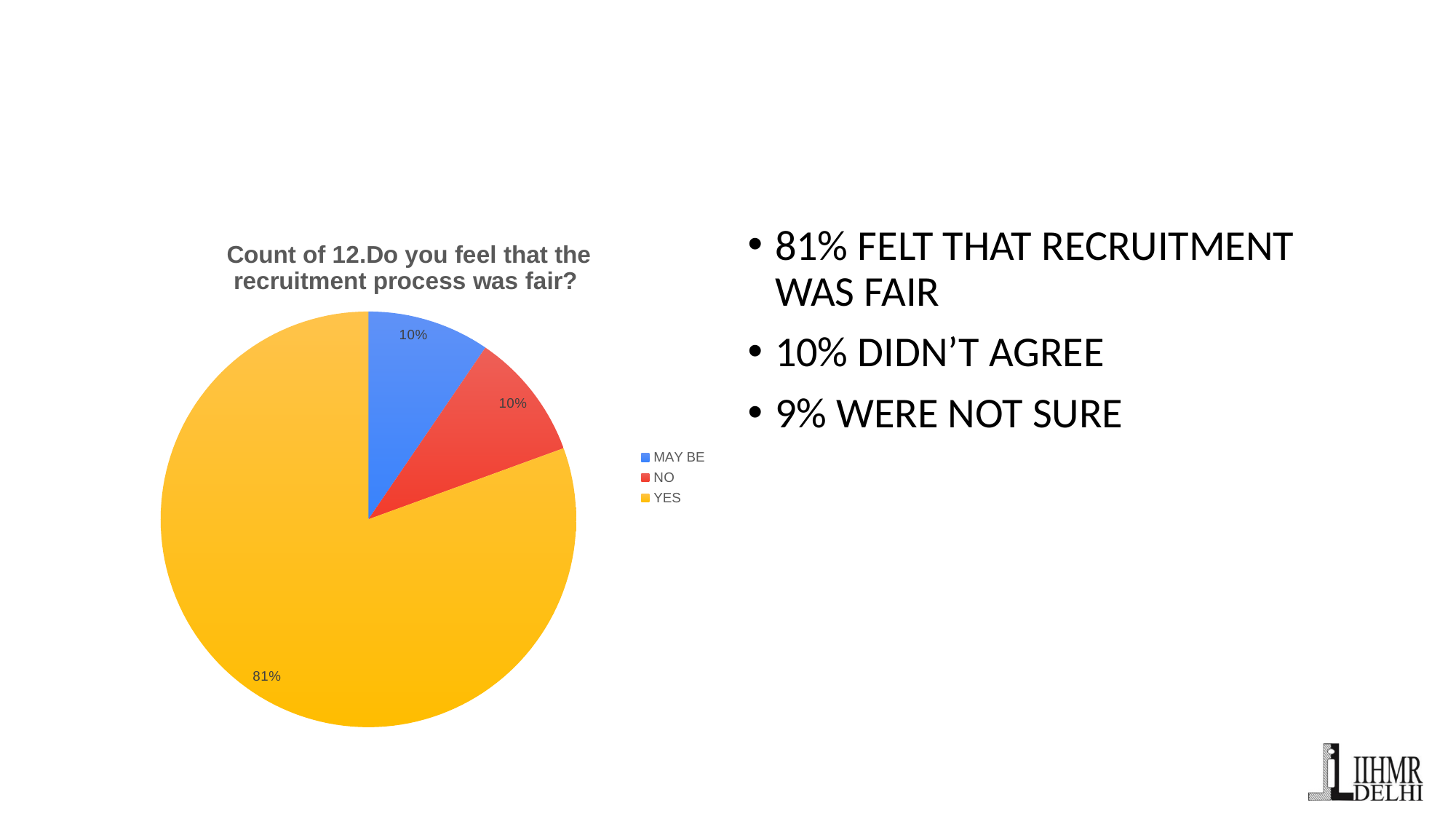
Is the share for YES greater or less than 50%? greater What is the difference in percentage points between the YES share and the MAY BE share? 71 What is the title of the chart? Count of 12.Do you feel that the recruitment process was fair? What percentage of the pie is labelled for YES? 81% What percentage of the pie is labelled for MAY BE? 10% Which is larger, the share for YES or the share for NO? YES Which category has the largest share of the pie? YES What percentage of the pie is labelled for NO? 10% How many categories does the legend list? 3 What type of chart is shown on the slide? Pie chart What colour represents YES in the pie chart? Yellow